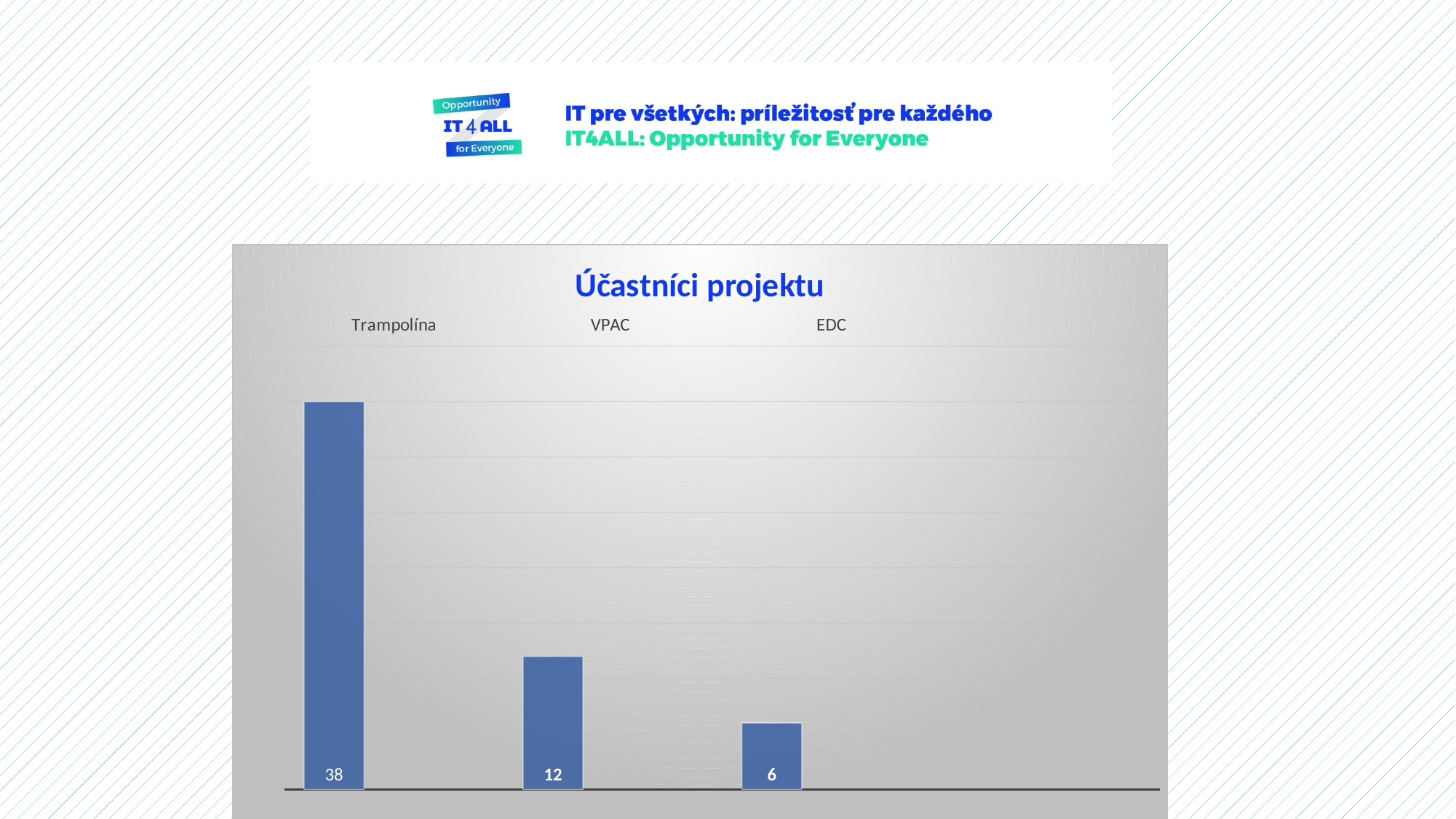
What kind of chart is shown on the slide? bar chart What is the value for Trampolína? 38 What is the value for VPAC? 12 What is the title of the chart? Účastníci projektu How many categories are shown in the chart? 3 Which is larger, the value for VPAC or the value for EDC? VPAC Do the values rise or fall from left to right across the categories? fall What is the difference between the values for VPAC and EDC? 6 Which category has the lowest value? EDC Which category has the highest value? Trampolína What is the difference between the values for Trampolína and VPAC? 26 What is the value for EDC? 6